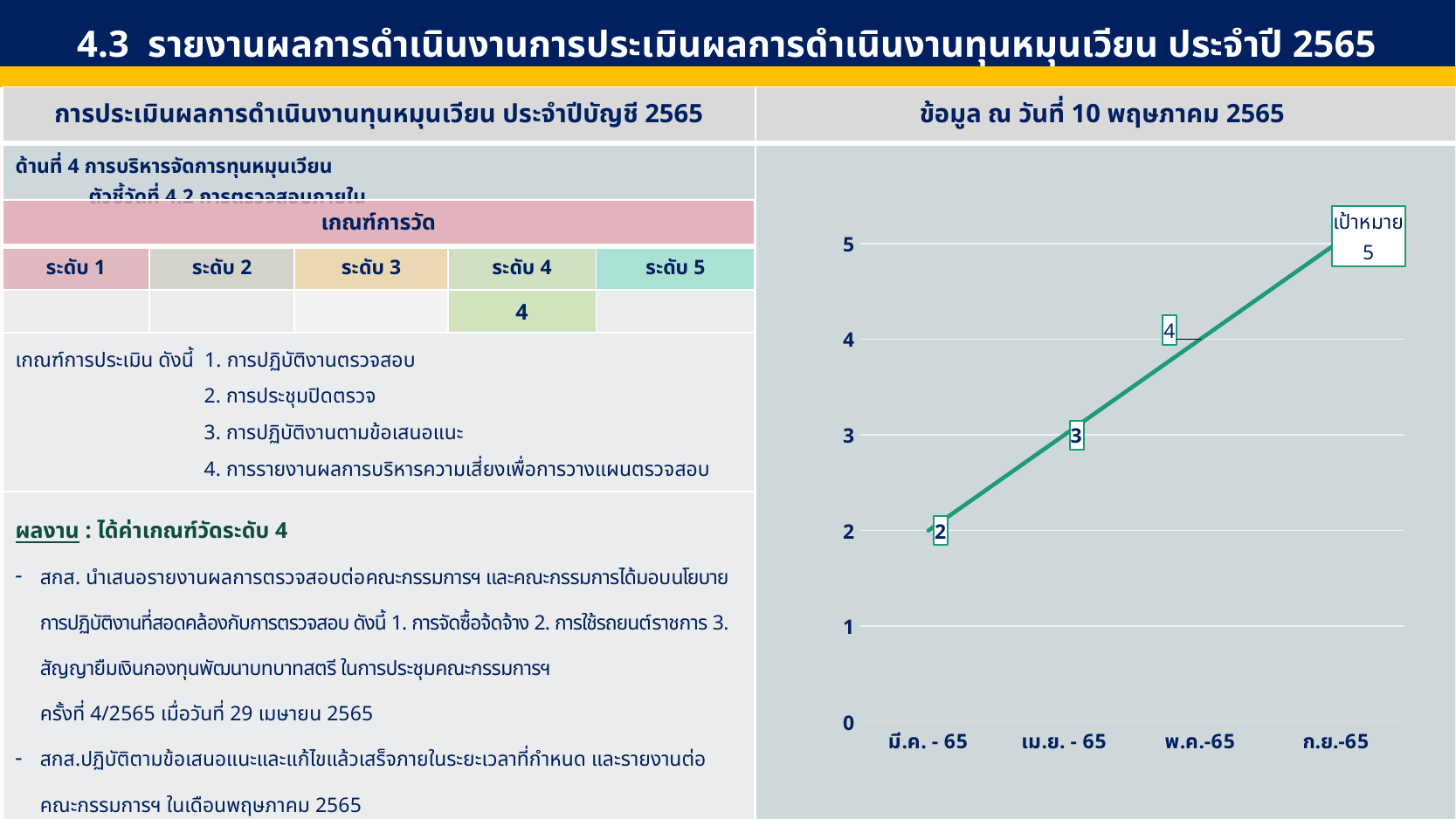
Which is larger, the value for เม.ย. - 65 or the value for พ.ค.-65? พ.ค.-65 Which category on the x axis has the highest value? ก.ย.-65 Which category on the x axis has the lowest value? มี.ค. - 65 What is the value plotted for เม.ย. - 65? 3 Do the plotted values rise or fall from left to right along the x axis? rise What is the value plotted for พ.ค.-65? 4 What label is attached to the last point of the line at ก.ย.-65? เป้าหมาย 5 What is the value plotted for ก.ย.-65? 5 What is the difference between the value for ก.ย.-65 and the value for มี.ค. - 65? 3 What kind of chart is shown on the right side of the slide? line chart How many categories are shown on the x axis of the chart? 4 What is the value plotted for มี.ค. - 65? 2